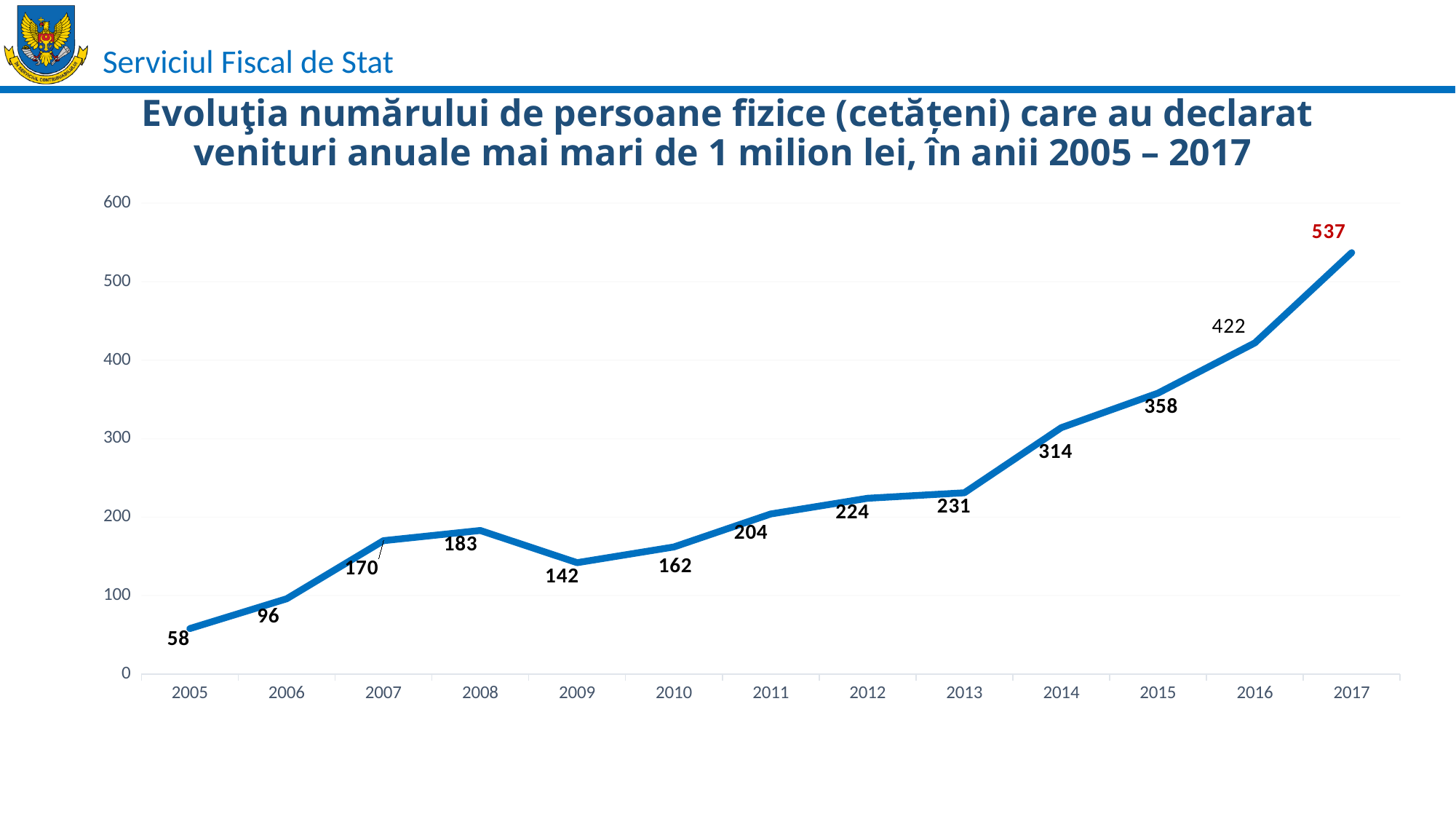
Which is larger, the value for 2008 or the value for 2010? 2008 What kind of chart is shown on the slide? line chart What is the difference between the values for 2008 and 2009? 41 What is the value for 2014? 314 How many years are plotted on the chart? 13 Which year has the lowest value? 2005 Which year has the highest value? 2017 Is the value for 2015 greater or less than 300? greater What is the value for 2009? 142 Do the values generally rise or fall from 2005 to 2017? rise What is the value for 2005? 58 What is the difference between the values for 2017 and 2016? 115